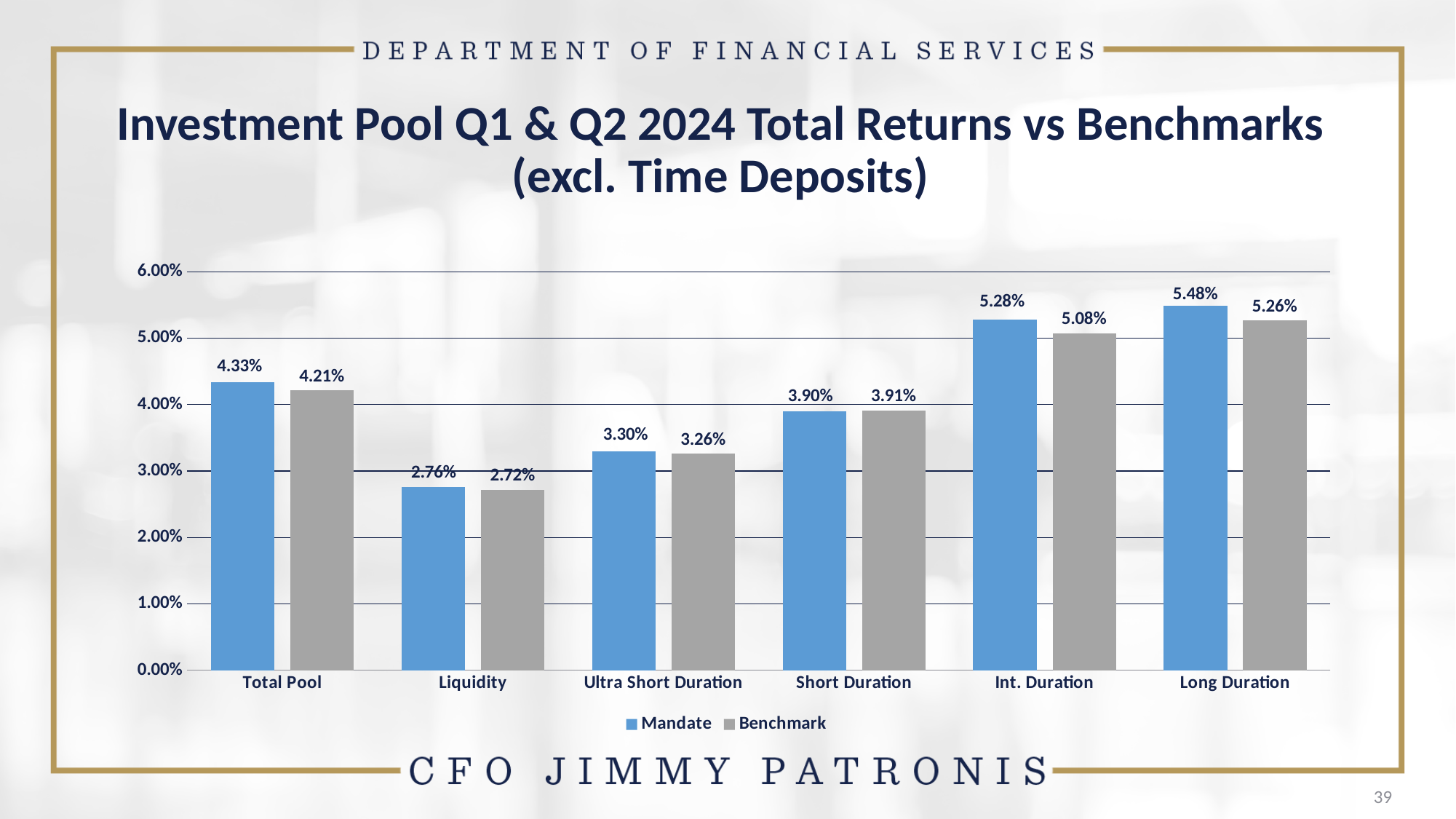
What is the Mandate value for Int. Duration? 5.28% What colour are the Benchmark bars? Gray Which is larger for Ultra Short Duration, the Mandate value or the Benchmark value? Mandate What kind of chart is shown on the slide? Bar chart How many series does the legend list? 2 What is the difference between the Mandate and Benchmark values for Int. Duration? 0.20% How many categories are shown on the x axis? 6 What is the Benchmark value for Short Duration? 3.91% What is the Mandate value for Total Pool? 4.33% What is the Benchmark value for Liquidity? 2.72% Which category has the highest Mandate value? Long Duration Which category has the lowest Benchmark value? Liquidity